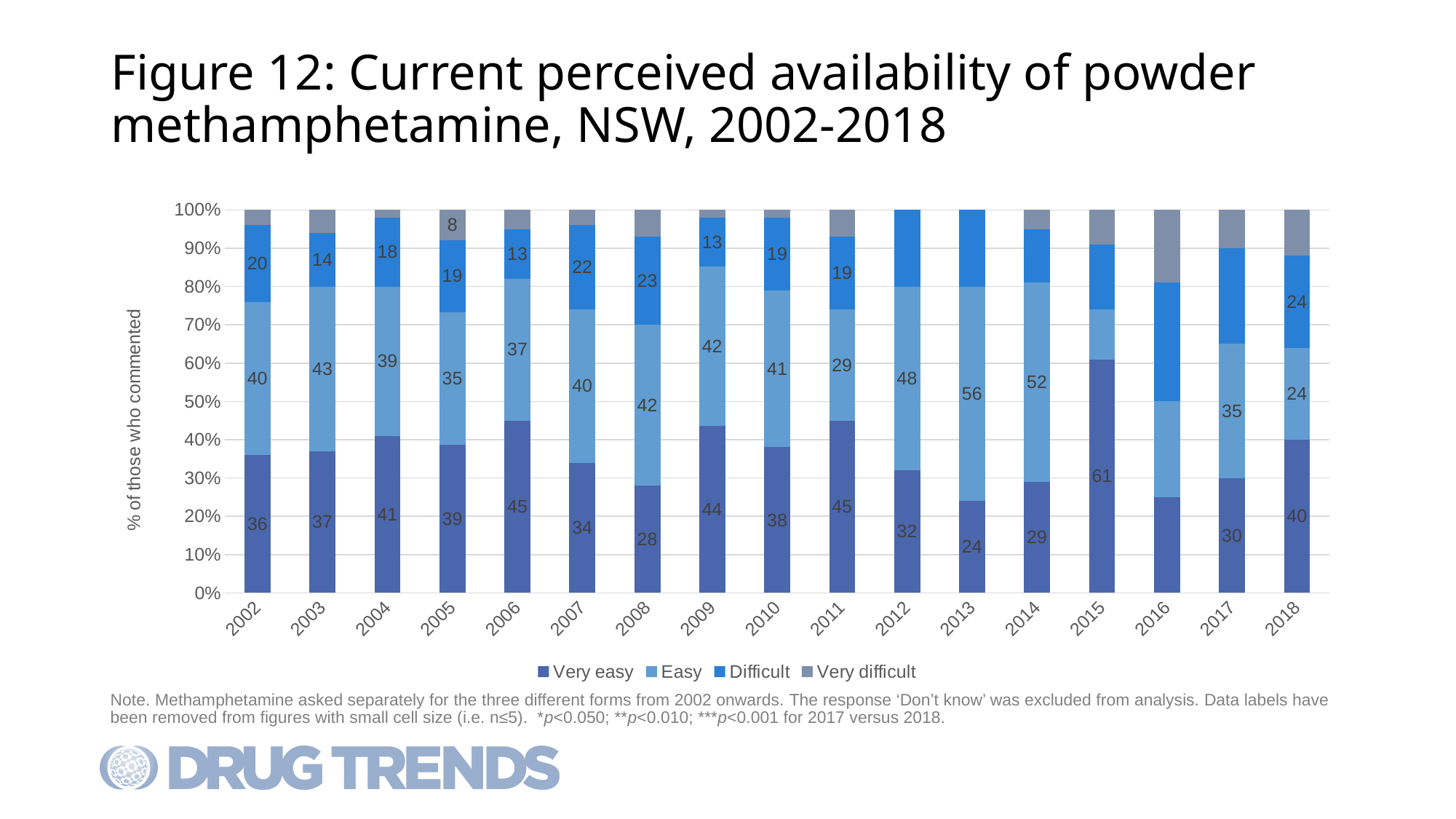
How many years are shown on the x axis? 17 What percentage of respondents rated powder methamphetamine as 'Very easy' to obtain in 2015? 61 What is the 'Very difficult' value shown for 2005? 8 How many series does the legend list? 4 In which year is the 'Very easy' segment the largest? 2015 What kind of chart is shown on the slide? Stacked bar chart Is the 'Very easy' value for 2016 greater or less than 30%? less What is the 'Easy' value for 2013? 56 In which year is the 'Easy' segment the largest? 2013 Which year has the larger 'Very easy' value, 2006 or 2007? 2006 What is the difference between the 'Very easy' values for 2015 and 2013? 37 Does the 'Very easy' value rise or fall from 2011 to 2013? Fall